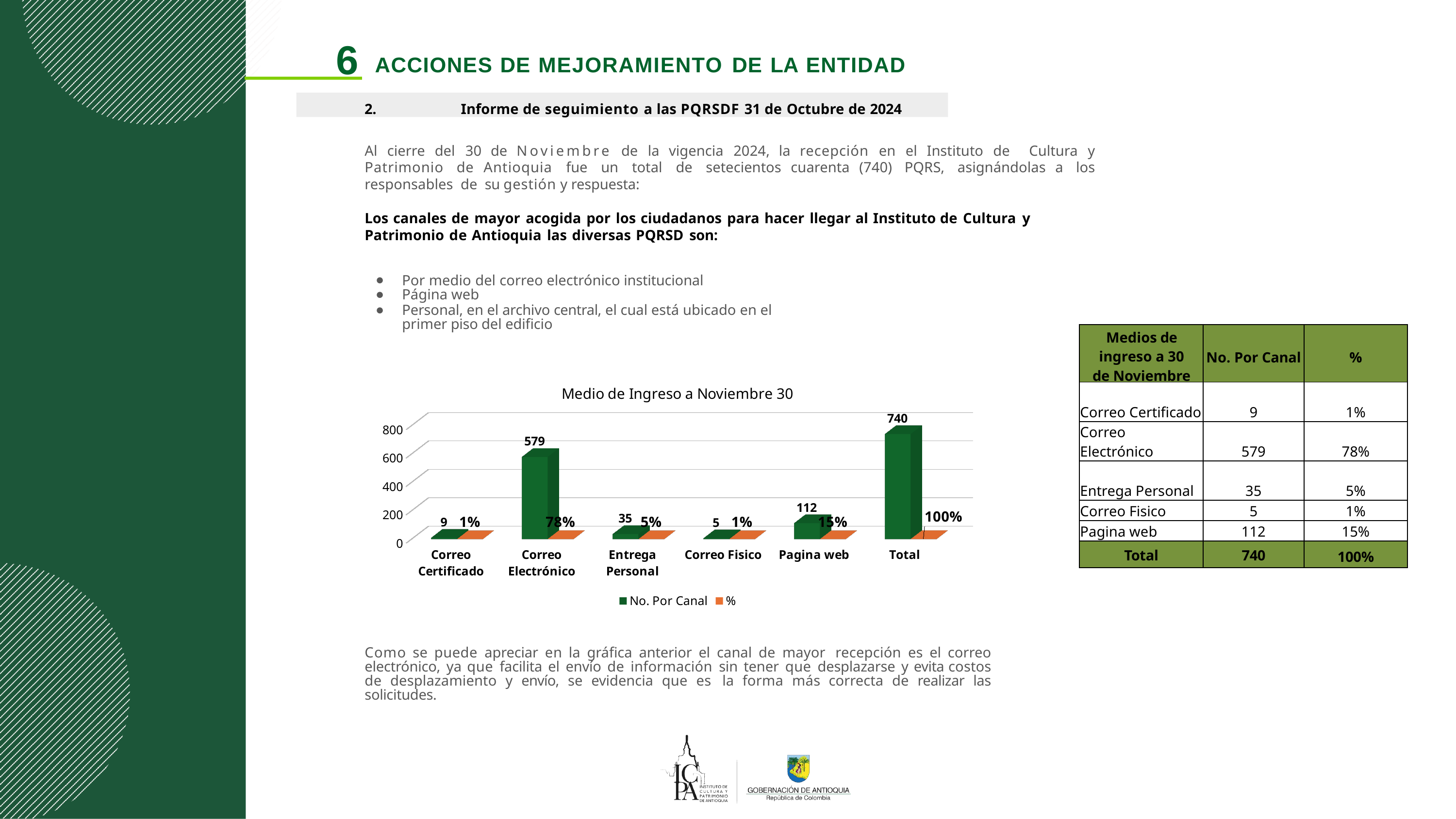
Excluding the Total bar, which category has the lowest No. Por Canal value? Correo Fisico What type of chart is shown on the slide? bar chart What is the No. Por Canal value for Correo Fisico? 5 Excluding the Total bar, which category has the highest No. Por Canal value? Correo Electrónico Which has a larger No. Por Canal value, Entrega Personal or Correo Certificado? Entrega Personal How many series does the chart legend list? 2 What is the No. Por Canal value for Pagina web? 112 What is the title of the chart? Medio de Ingreso a Noviembre 30 How many categories are shown on the x axis of the chart? 6 What percentage is shown for Entrega Personal? 5% What is the difference in No. Por Canal between Correo Electrónico and Pagina web? 467 What is the No. Por Canal value for Correo Electrónico? 579